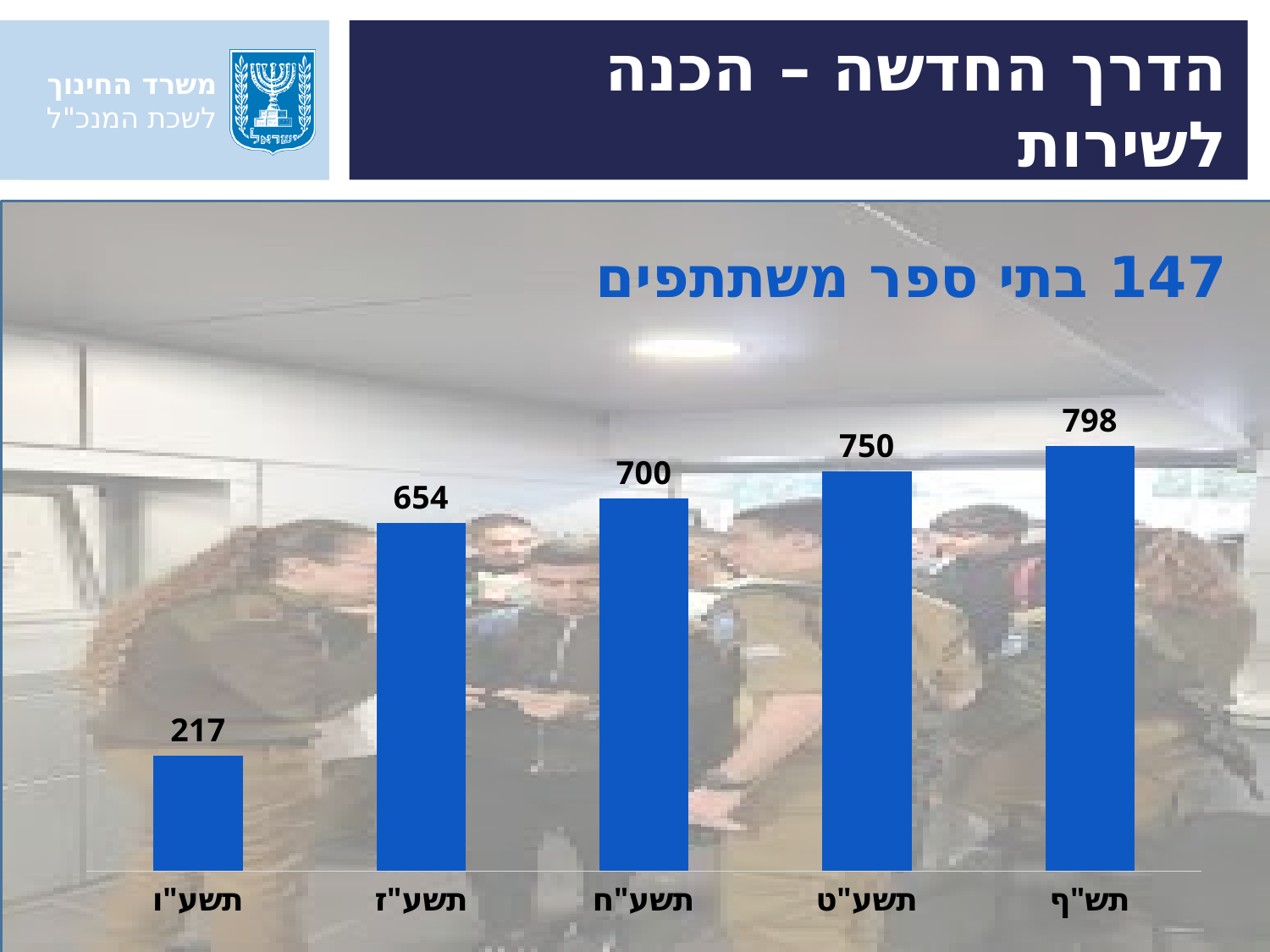
What kind of chart is shown on the slide? bar chart Which category has the lowest value? תשע"ו What is the value for תשע"ו? 217 What is the value for תשע"ח? 700 Do the values rise or fall from left to right along the x axis? rise What is the heading text shown above the chart? 147 בתי ספר משתתפים What is the difference between the values for תשע"ז and תשע"ו? 437 What is the value for תש"ף? 798 How many bars are shown in the chart? 5 Which category has the highest value? תש"ף What is the difference between the values for תש"ף and תשע"ט? 48 Which is larger, the value for תשע"ט or the value for תשע"ח? תשע"ט